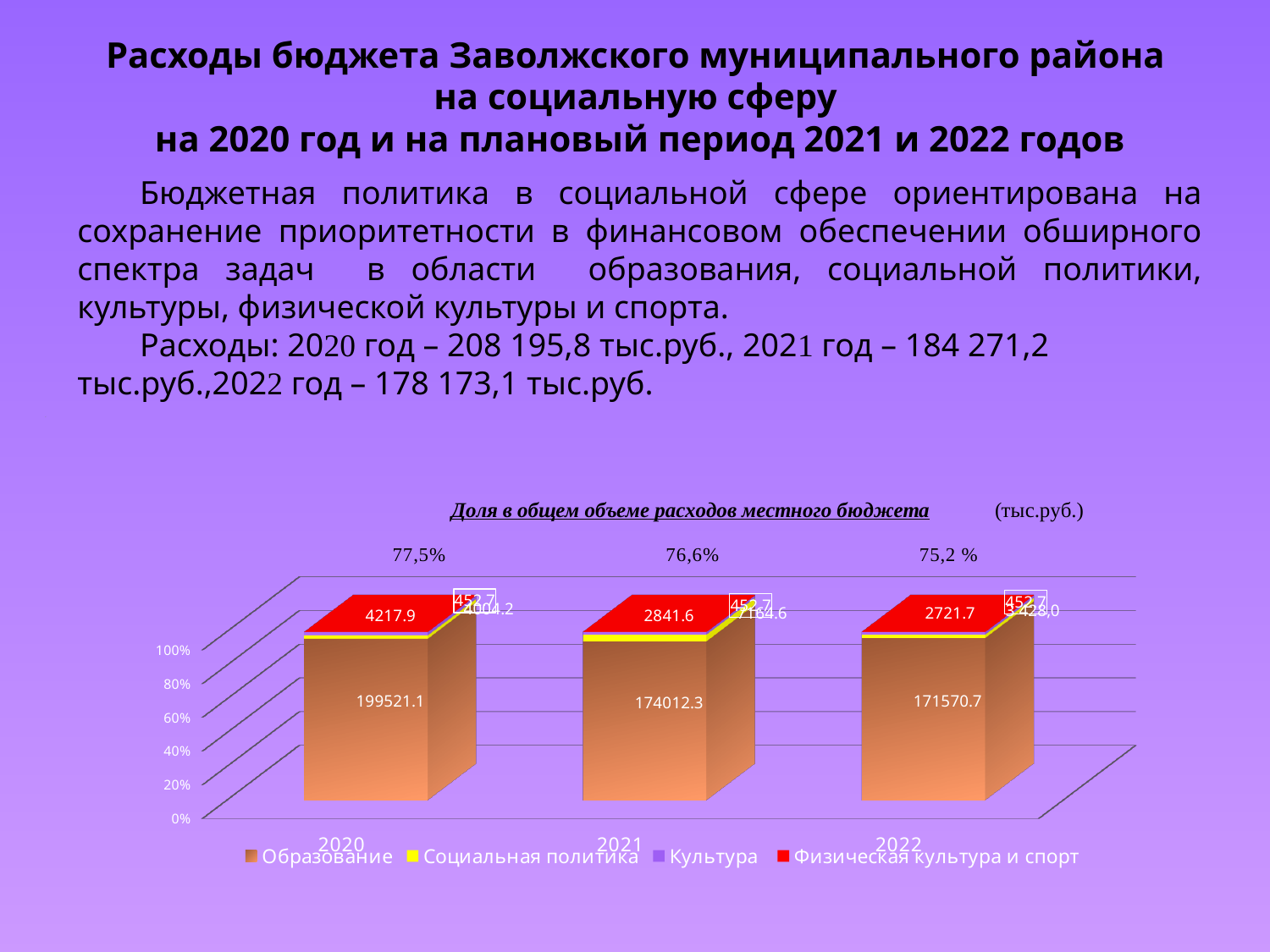
What is the difference between the Образование values for 2020 and 2021? 25508.8 What share of total local budget expenditures is shown above the 2021 bar? 76,6% What is the value for Физическая культура и спорт in 2021? 452.7 What is the value for Образование in 2022? 171570.7 In which year is the value for Образование the highest? 2020 What kind of chart is shown on the slide? stacked bar chart How many series does the chart legend list? 4 What is the value for Образование in 2020? 199521.1 How many years (categories) are shown on the x axis of the chart? 3 Does the value for Образование rise or fall from 2020 to 2022? fall Which is larger: the Физическая культура и спорт value for 2020 or for 2022? Neither; both are 452.7